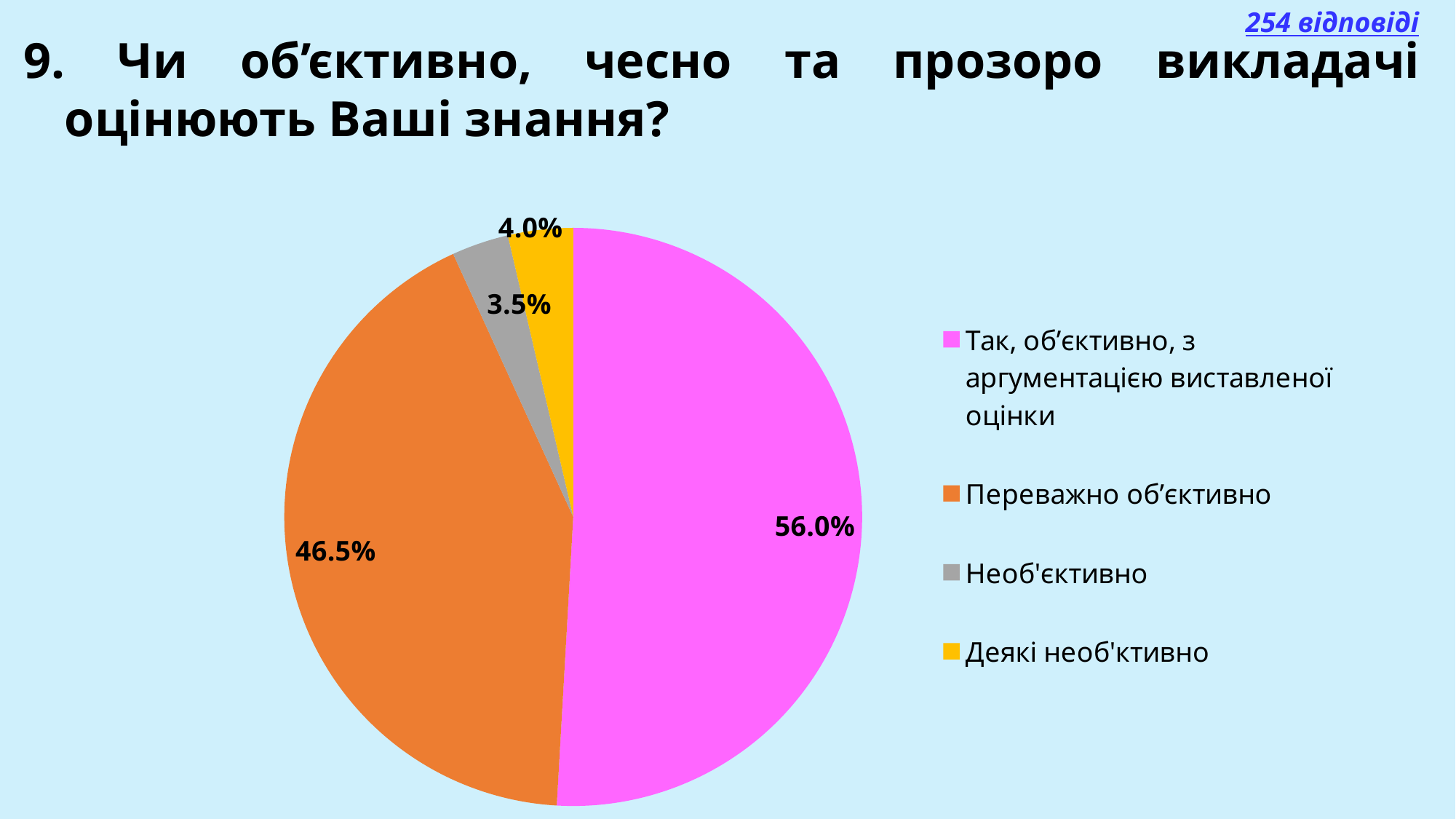
How many slices does the pie chart have? 4 What percentage is shown for the slice "Переважно об’єктивно"? 46.5% Which category has the smallest slice of the pie? Необ'єктивно What percentage is shown for the slice "Деякі необ'ктивно"? 4.0% What kind of chart is shown on the slide? Pie chart Which is larger: the slice for "Так, об’єктивно, з аргументацією виставленої оцінки" or the slice for "Переважно об’єктивно"? Так, об’єктивно, з аргументацією виставленої оцінки What percentage is shown for the slice "Необ'єктивно"? 3.5% Which category has the largest slice of the pie? Так, об’єктивно, з аргументацією виставленої оцінки How many responses does the slide say the chart is based on? 254 What percentage is shown for the slice "Так, об’єктивно, з аргументацією виставленої оцінки"? 56.0% What colour is the slice for "Переважно об’єктивно"? Orange What is the difference in percentage points between the "Так, об’єктивно, з аргументацією виставленої оцінки" slice and the "Переважно об’єктивно" slice? 9.5 percentage points